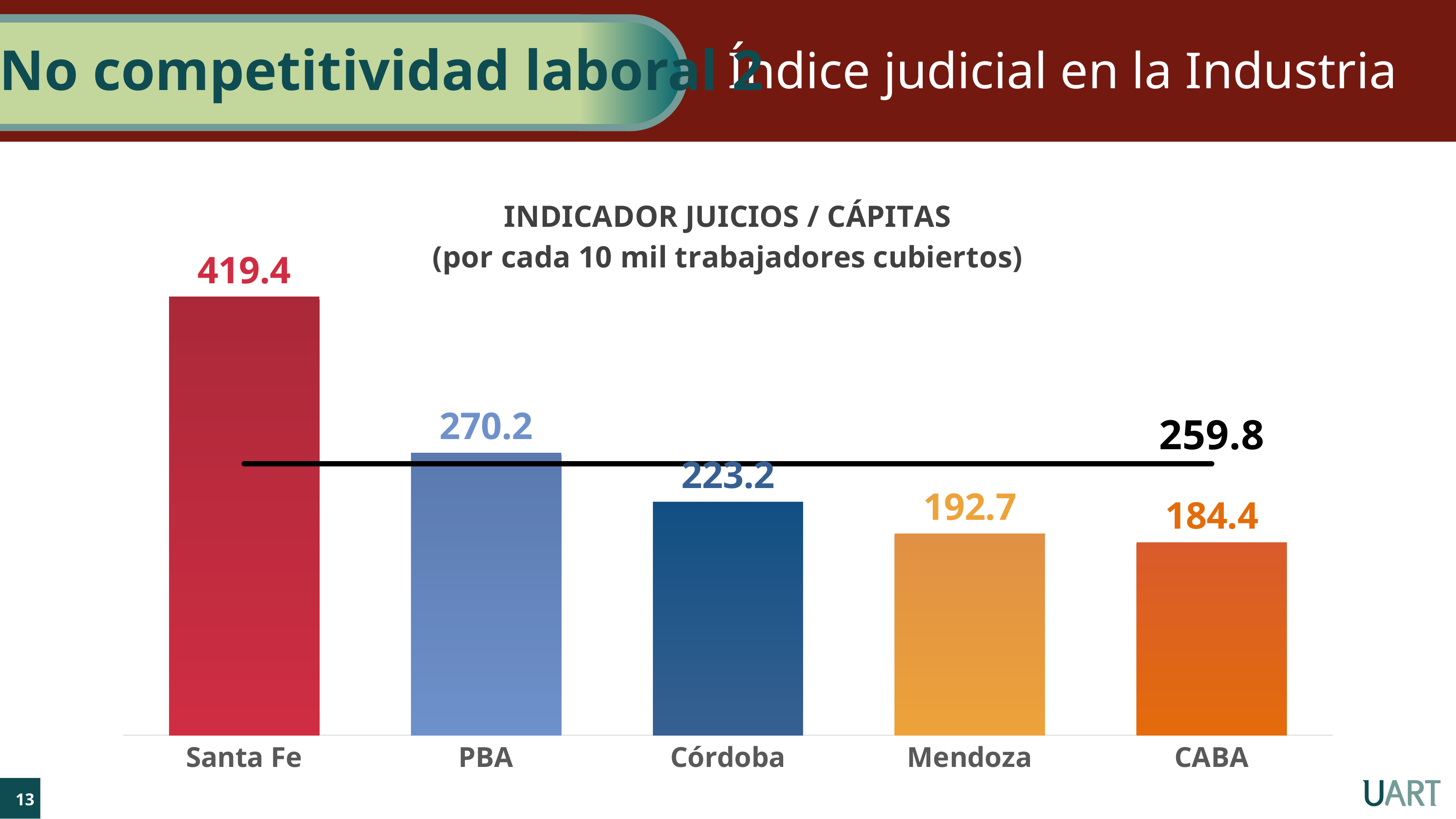
Which category has the lowest value? CABA What is the difference between the values for Santa Fe and PBA? 149.2 What is the value for CABA? 184.4 How many categories are shown in the chart? 5 What value is labelled on the horizontal reference line across the chart? 259.8 What is the value for Córdoba? 223.2 Which is larger, the value for Córdoba or the value for Mendoza? Córdoba What kind of chart is shown on the slide? Bar chart Which category has the highest value? Santa Fe What is the value for Santa Fe? 419.4 What is the value for Mendoza? 192.7 What is the value for PBA? 270.2